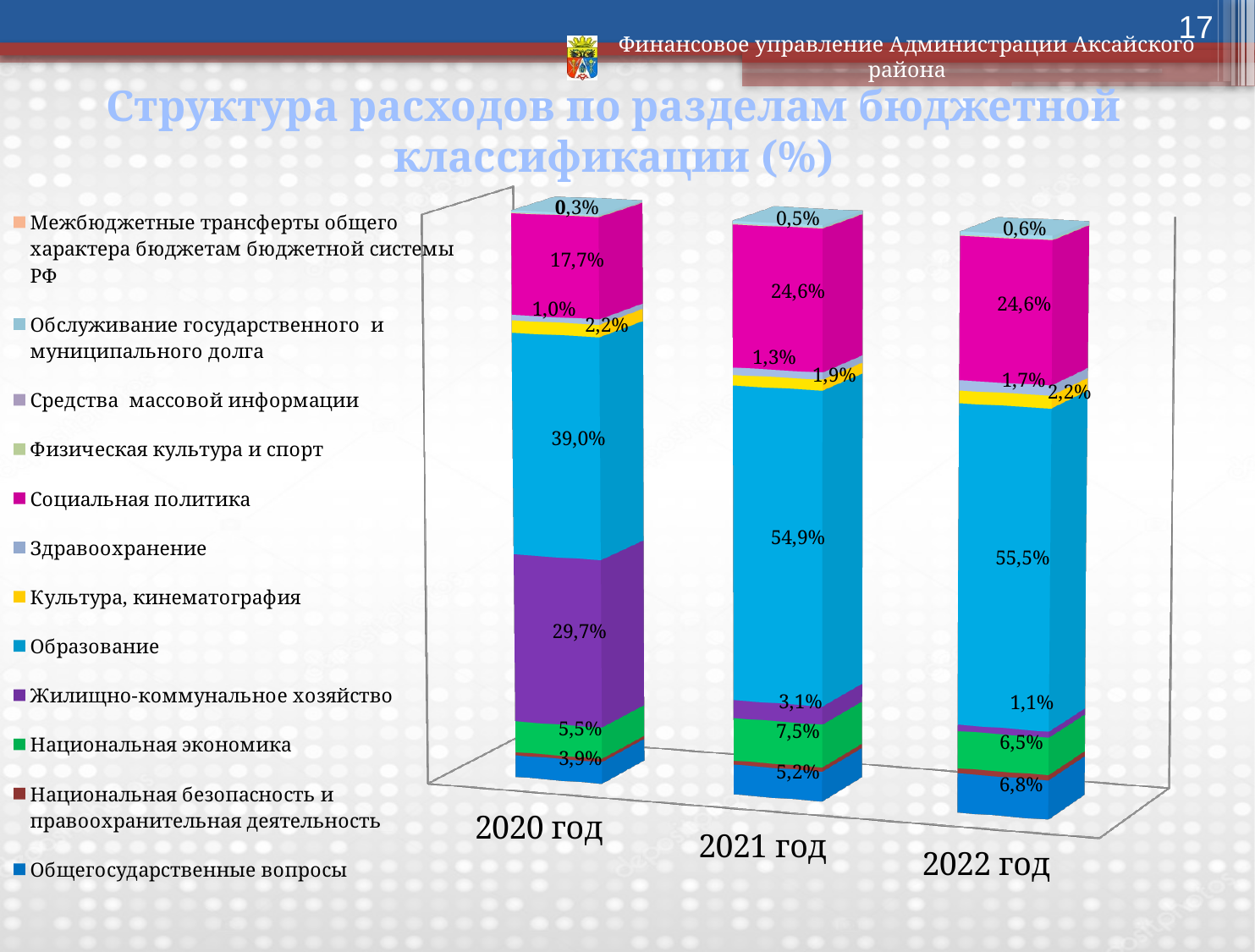
What is the share of Общегосударственные вопросы (general state issues) in 2022? 6,8% How many series does the legend list? 12 What is the share of Образование (education) in 2020? 39,0% What is the share of Образование (education) in 2022? 55,5% How many years (bars) are shown in the chart? 3 How does the share of Жилищно-коммунальное хозяйство (housing and communal services) change from 2020 to 2022? It falls What is the share of Социальная политика (social policy) in 2021? 24,6% In which year is the share of Образование (education) the lowest? 2020 год By how many percentage points did the share of Образование (education) change between 2020 and 2022? 16,5 What is the share of Жилищно-коммунальное хозяйство (housing and communal services) in 2020? 29,7% What type of chart is shown on the slide? Stacked bar chart Which year has the larger share of Национальная экономика (national economy): 2021 or 2022? 2021 год